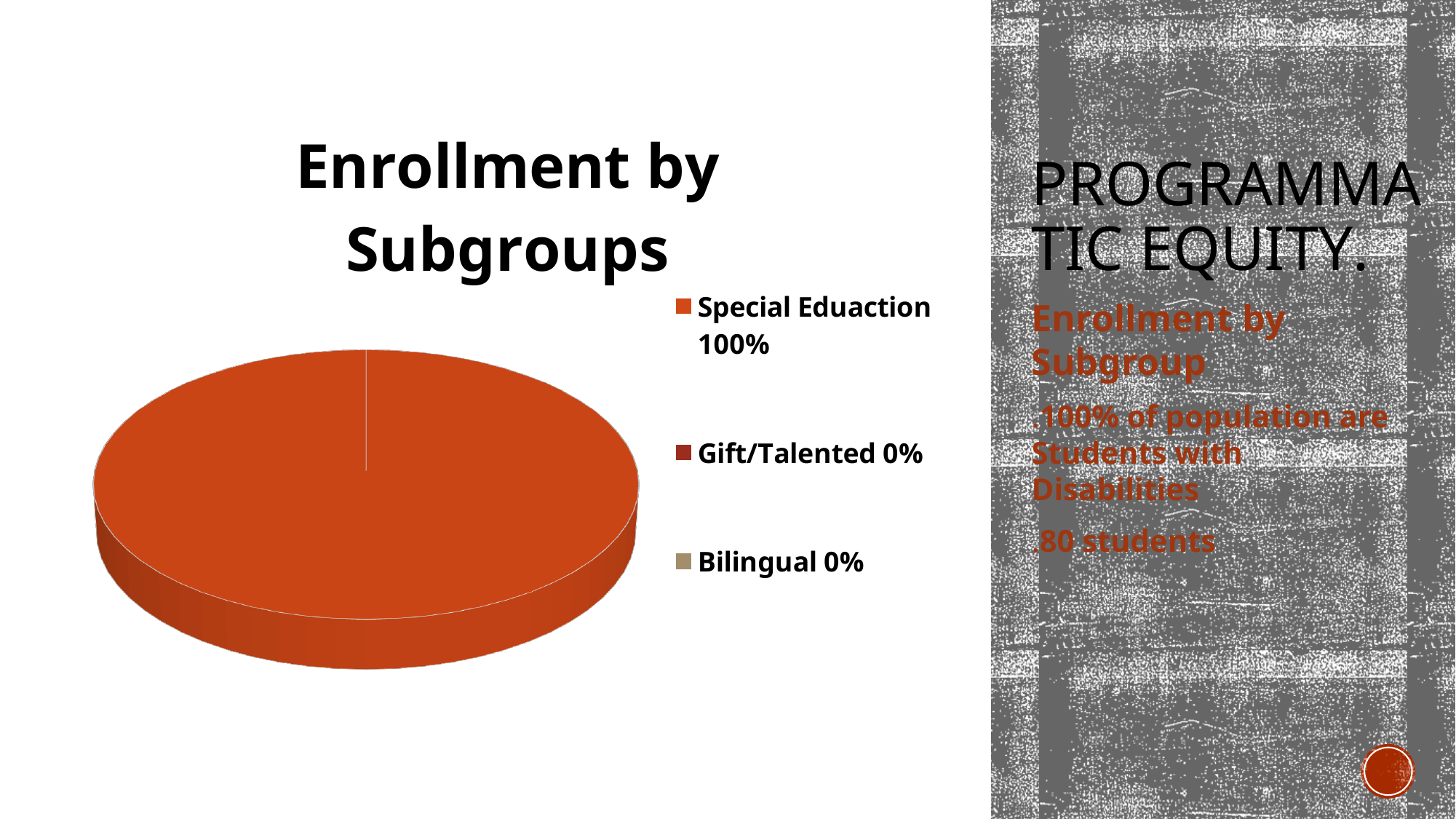
How many categories does the legend of the pie chart list? 3 Which is larger, the share for Special Eduaction or the share for Bilingual? Special Eduaction What share of the pie does Special Eduaction have? 100% Which category has the largest share of the pie? Special Eduaction What share of the pie does Gift/Talented have? 0% Which legend entry is listed first in the pie chart's legend? Special Eduaction 100% What kind of chart is shown on the slide? pie chart What is the difference between the share for Special Eduaction and the share for Gift/Talented? 100% What is the title of the chart? Enrollment by Subgroups What share of the pie does Bilingual have? 0%